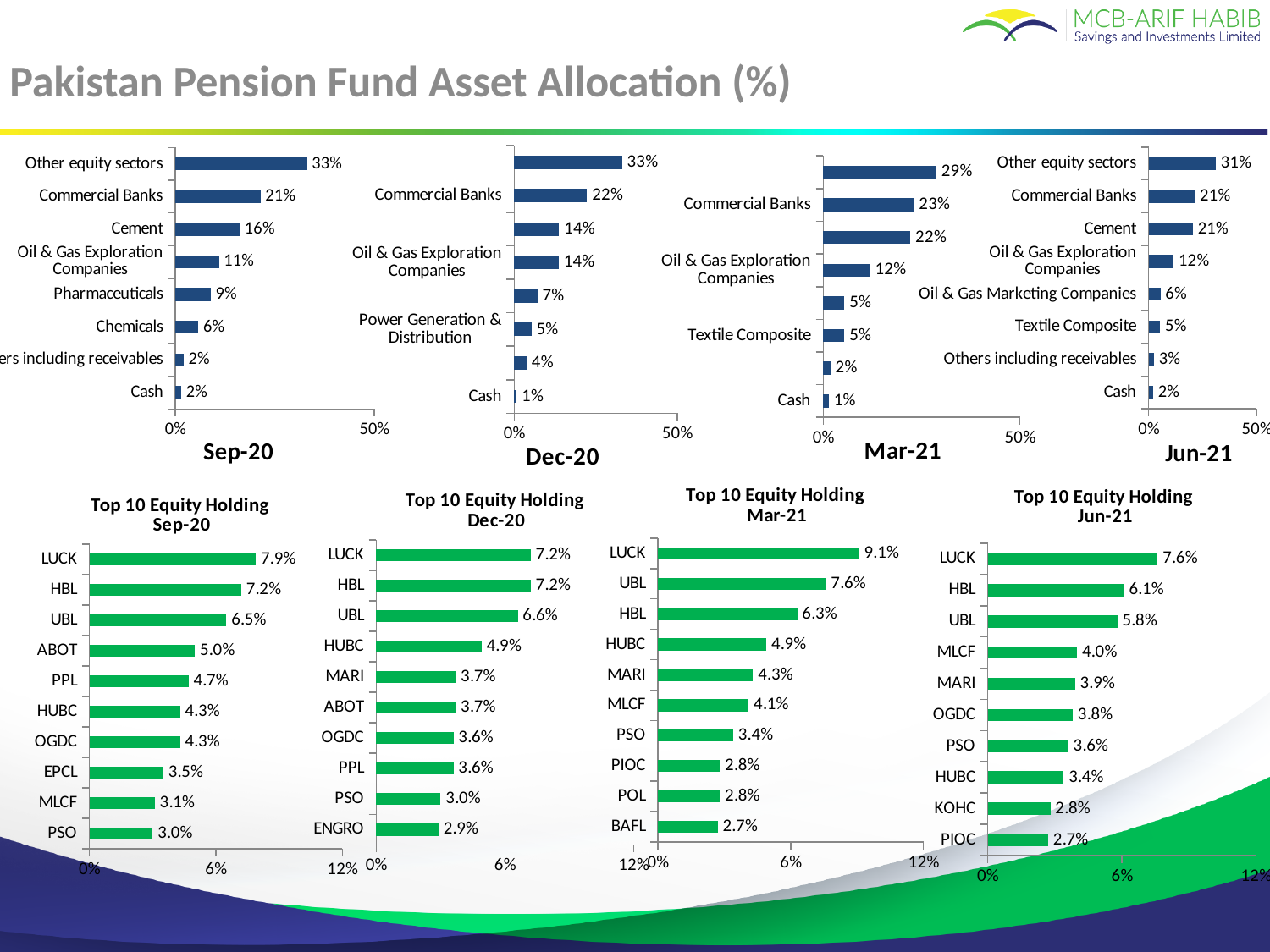
In the Sep-20 asset allocation chart, what is the value for Cement? 16% In the Top 10 Equity Holding Dec-20 chart, which is larger, HUBC or MARI? HUBC What kind of chart is the Top 10 Equity Holding Jun-21 chart? Bar chart In the Top 10 Equity Holding Mar-21 chart, which holding is the highest? LUCK In the Dec-20 asset allocation chart, what is the value for Power Generation & Distribution? 5% How many holdings are shown in the Top 10 Equity Holding Mar-21 chart? 10 In the Top 10 Equity Holding Jun-21 chart, which holding is the lowest? PIOC In the Mar-21 asset allocation chart, what is the value for Commercial Banks? 23% In the Top 10 Equity Holding Jun-21 chart, what is the value for MLCF? 4.0% In the Top 10 Equity Holding Sep-20 chart, what is the difference between LUCK and PSO? 4.9% In the Jun-21 asset allocation chart, is the value for Other equity sectors greater or less than 50%? less In the Jun-21 asset allocation chart, what is the value for Oil & Gas Marketing Companies? 6%